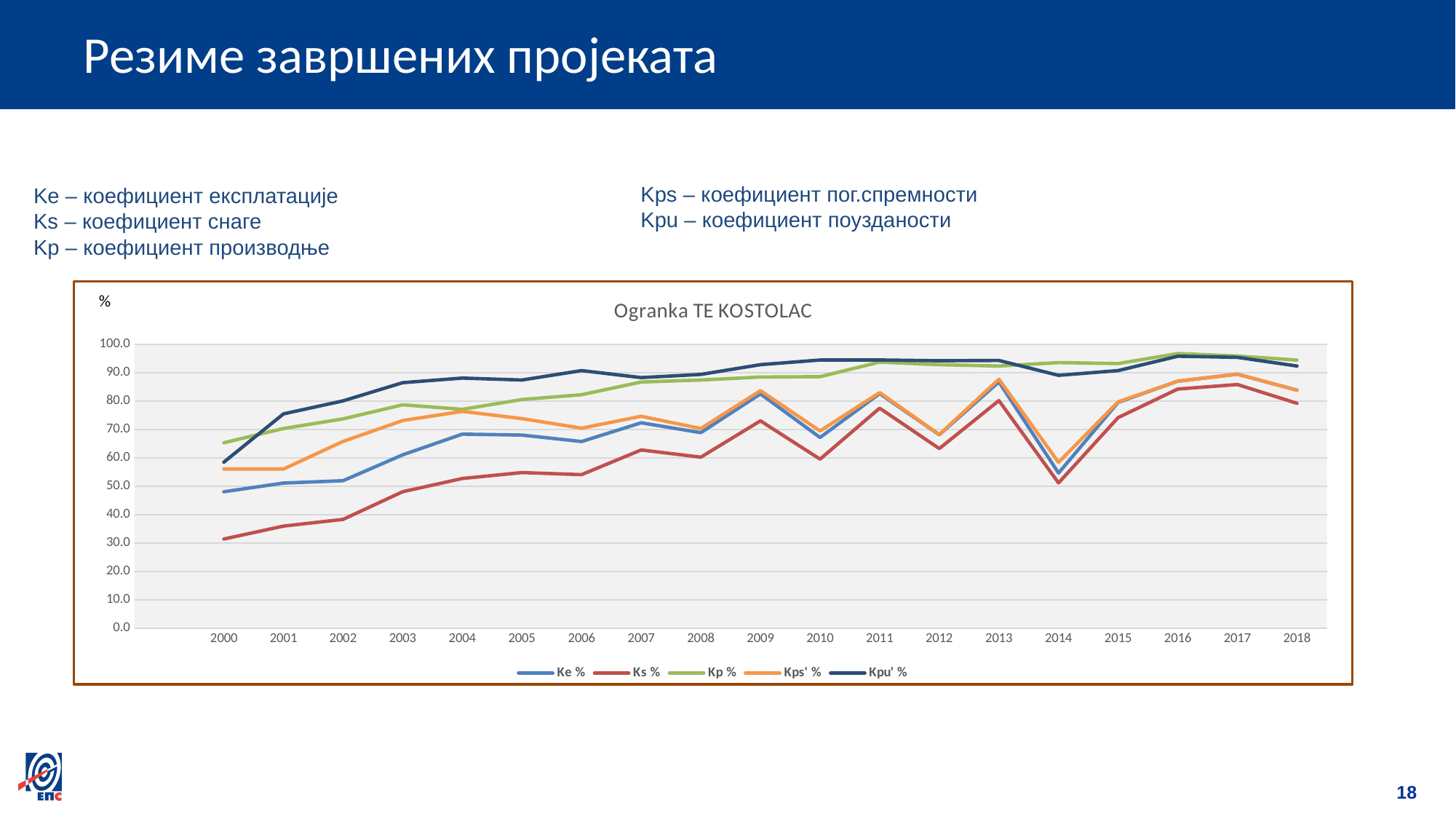
How many years are shown on the x axis of the chart? 19 Is the value of Ks % in 2000 greater or less than 40.0? less In 2005, which is higher: Kp % or Ks %? Kp % Which series has the highest value in 2010? Kpu' % Which series has the lowest value in 2000? Ks % What is the title of the chart? Ogranka TE KOSTOLAC Does the Ks % series generally rise or fall from 2000 to 2013? rise Is the value of Kp % in 2000 greater or less than 60.0? greater How many series does the chart legend list? 5 Is the value of Ke % in 2000 greater or less than 50.0? less What kind of chart is shown on the slide? line chart